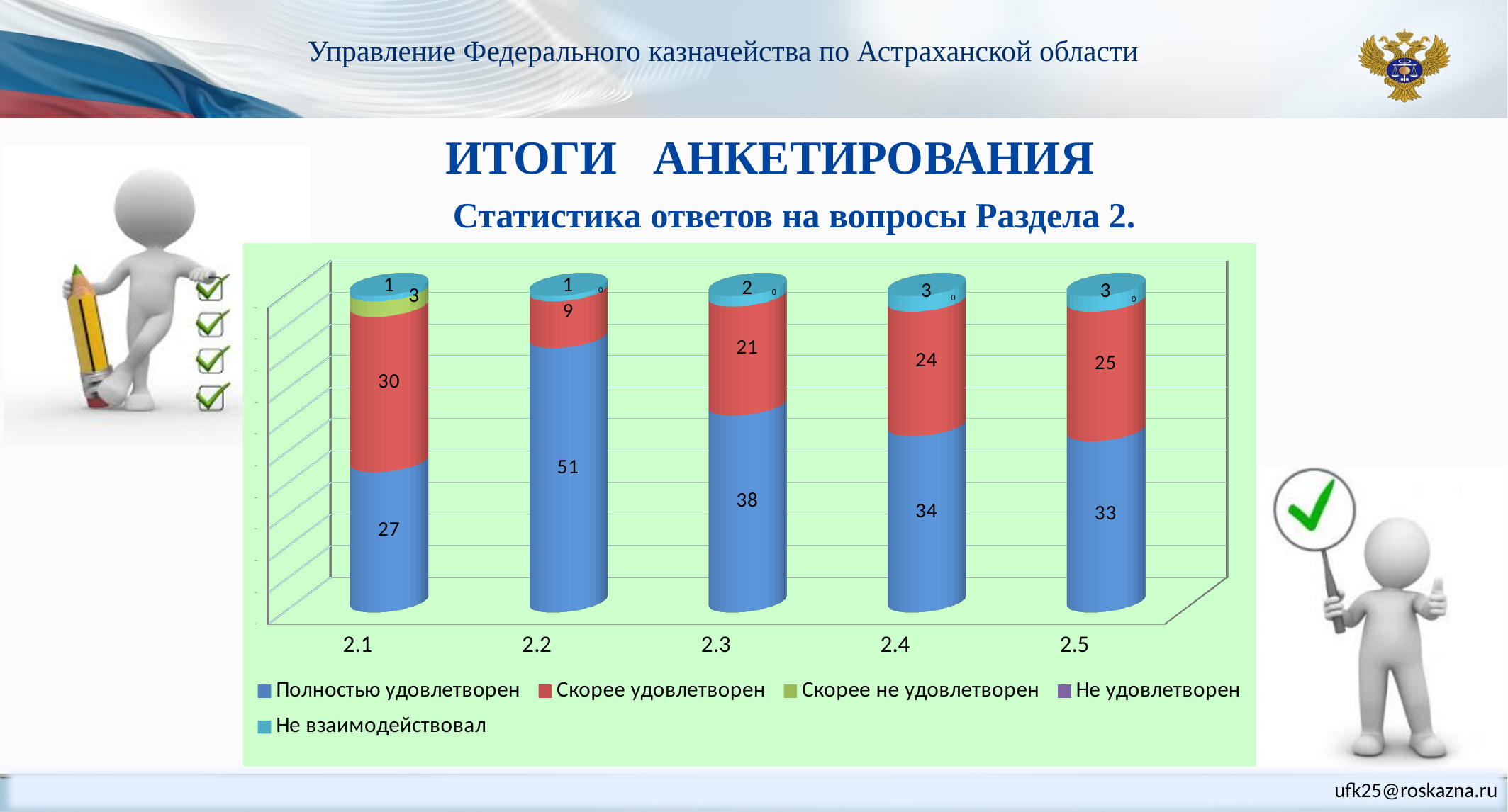
What kind of chart is shown on the slide? stacked bar chart How many series does the chart legend list? 5 What is the value of "Не взаимодействовал" for category 2.4? 3 What is the value of "Полностью удовлетворен" for category 2.2? 51 Which category has the lowest value for "Полностью удовлетворен"? 2.1 Which is larger: the "Скорее удовлетворен" value for 2.4 or for 2.5? 2.5 What is the value of "Скорее удовлетворен" for category 2.1? 30 What is the difference between the "Полностью удовлетворен" values for 2.2 and 2.3? 13 What is the subtitle printed above the chart? Статистика ответов на вопросы Раздела 2. How many categories are shown on the x axis of the chart? 5 Which category has the highest value for "Полностью удовлетворен"? 2.2 What is the value of "Скорее не удовлетворен" for category 2.1? 3